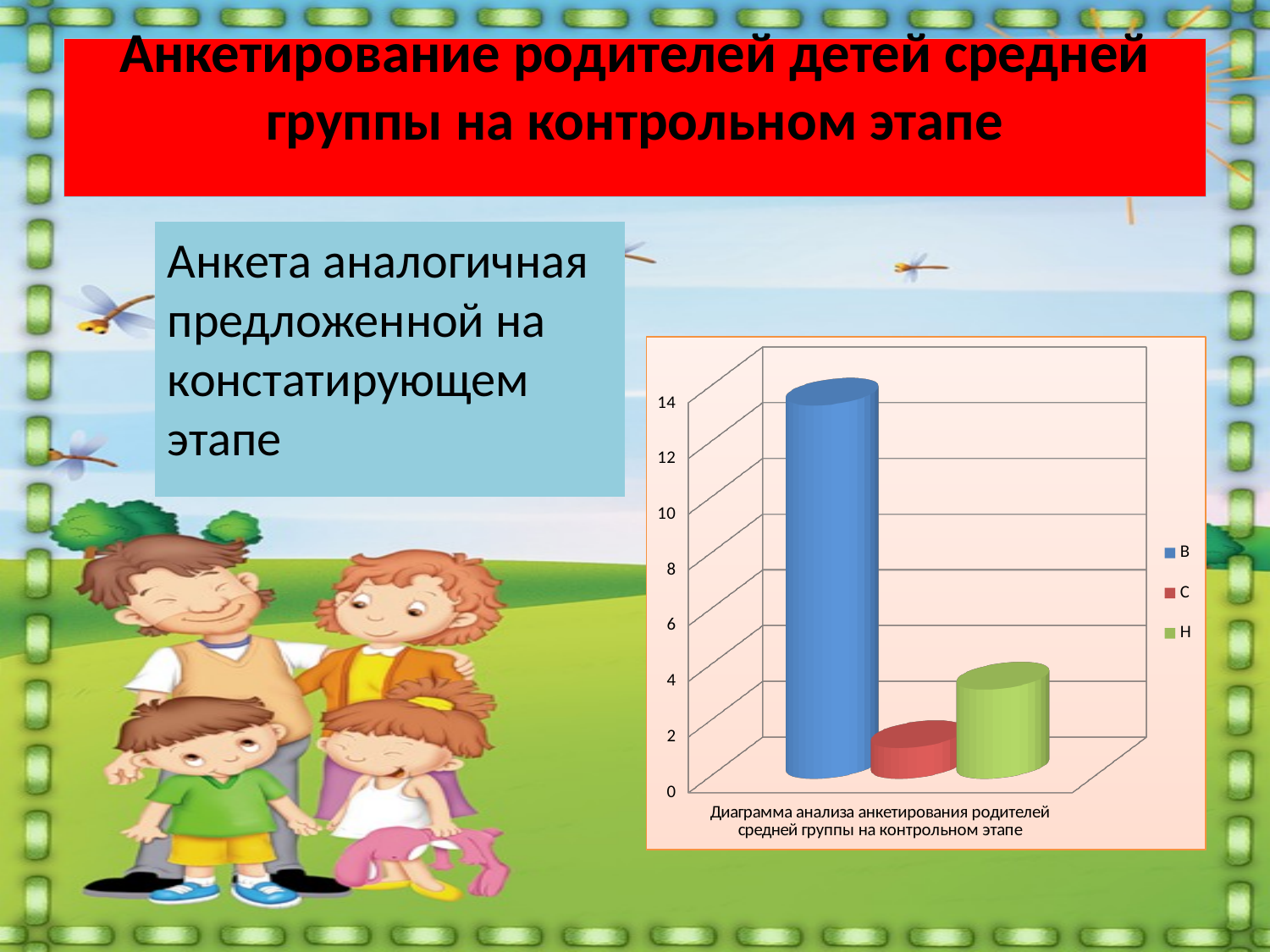
How many series does the chart legend list? 3 Is the value for В greater or less than 10? greater How many categories are shown on the x axis of the chart? 1 Is the value for С greater or less than 4? less Which series has the highest bar in the chart? В What colour is the bar for series Н in the chart? green Which is larger, the bar for Н or the bar for С? Н Which is larger, the bar for В or the bar for Н? В What is the category label shown under the bars on the x axis? Диаграмма анализа анкетирования родителей средней группы на контрольном этапе Which series has the lowest bar in the chart? С Is the value for Н greater or less than 8? less What kind of chart is shown on the slide? bar chart